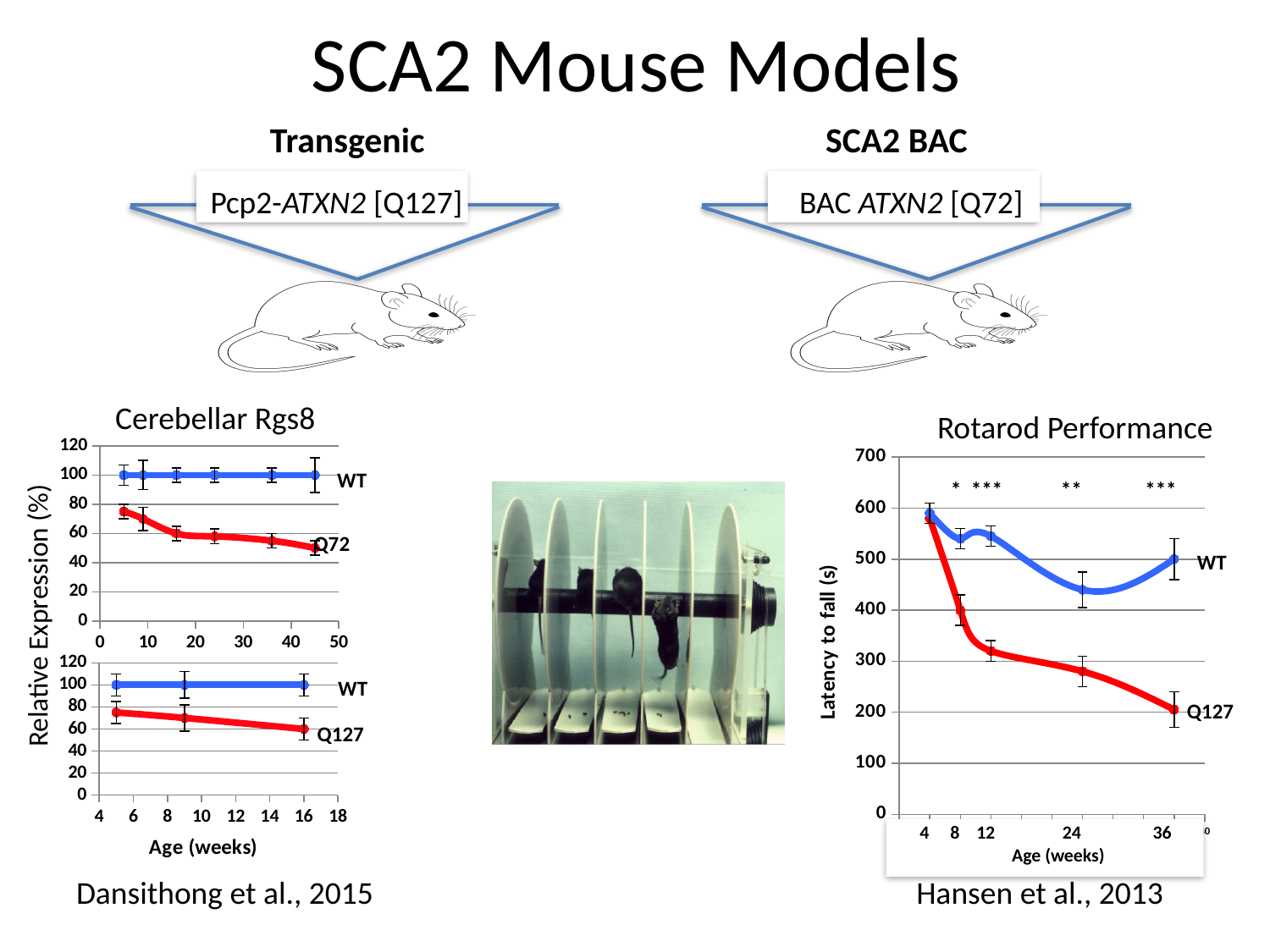
In the upper Cerebellar Rgs8 chart, what is the relative expression of WT? 100 What is the y-axis label of the Rotarod Performance chart? Latency to fall (s) In the lower Cerebellar Rgs8 chart, is the relative expression of Q127 at 16 weeks greater or less than 80? less In the Rotarod Performance chart, does the latency to fall for Q127 rise or fall with age? fall What kind of chart is the Rotarod Performance chart? line chart In the Rotarod Performance chart, is the latency to fall for Q127 at 36 weeks greater or less than 300? less In the upper Cerebellar Rgs8 chart, does the relative expression of Q72 rise or fall with age? fall In the lower Cerebellar Rgs8 chart, how many age points are plotted for the Q127 series? 3 In the Rotarod Performance chart, how many age points are plotted for the Q127 series? 5 In the Rotarod Performance chart, which series has the higher latency to fall at 36 weeks, WT or Q127? WT In the Rotarod Performance chart, is the latency to fall for WT at 36 weeks greater or less than 400? greater In the Rotarod Performance chart, how many series are plotted? 2